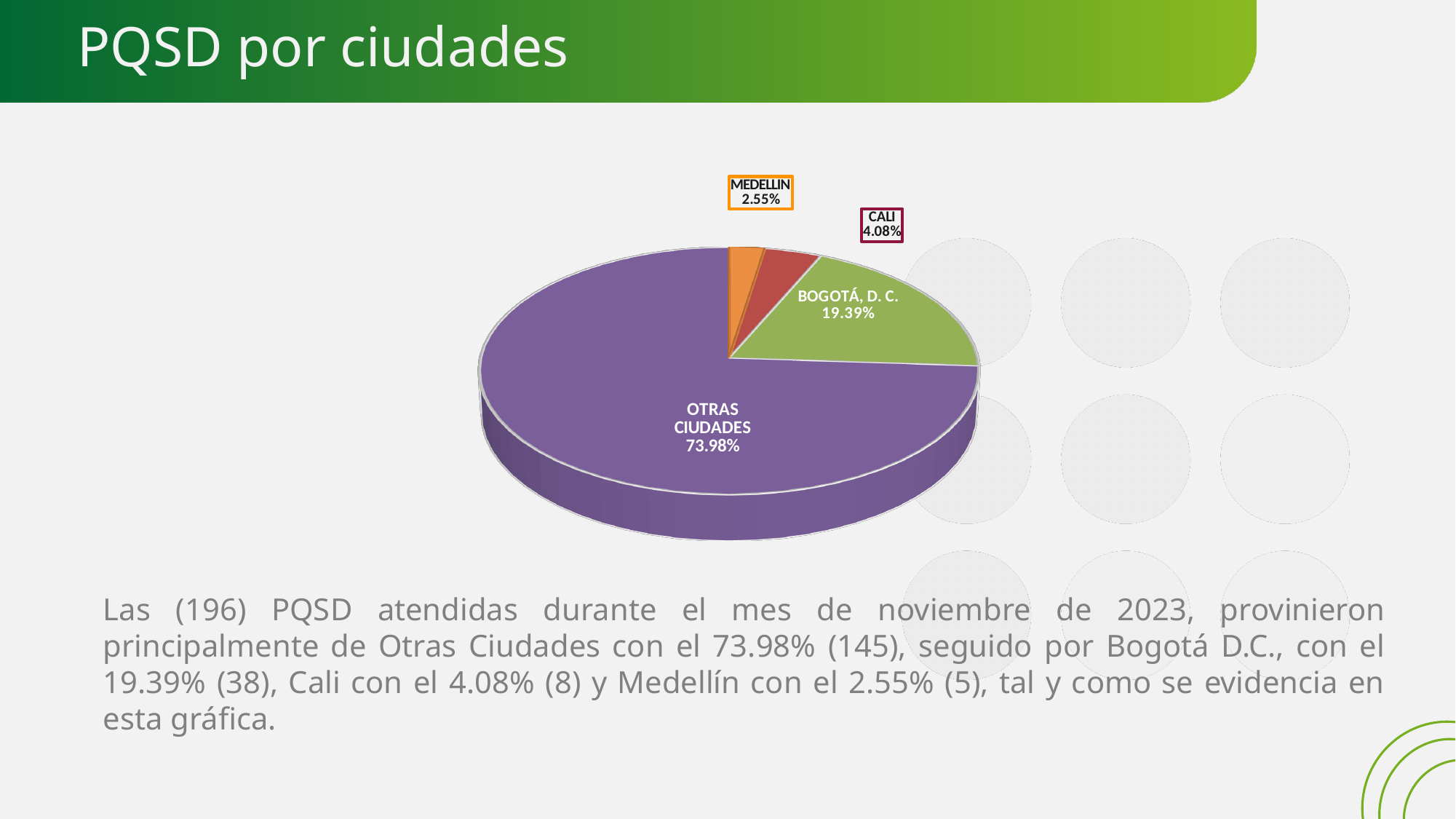
What colour is the slice for OTRAS CIUDADES? Purple What is the difference in percentage points between CALI and MEDELLIN? 1.53 What is the value shown for CALI? 4.08% How many slices does the pie chart have? 4 What is the value shown for MEDELLIN? 2.55% Which is larger, the slice for CALI or the slice for MEDELLIN? CALI Which category has the smallest slice of the pie? MEDELLIN What share of the pie does OTRAS CIUDADES represent? 73.98% What type of chart is shown on the slide? Pie chart What is the difference in percentage points between OTRAS CIUDADES and BOGOTÁ, D. C.? 54.59 What is the value shown for BOGOTÁ, D. C.? 19.39% Which category has the largest slice of the pie? OTRAS CIUDADES